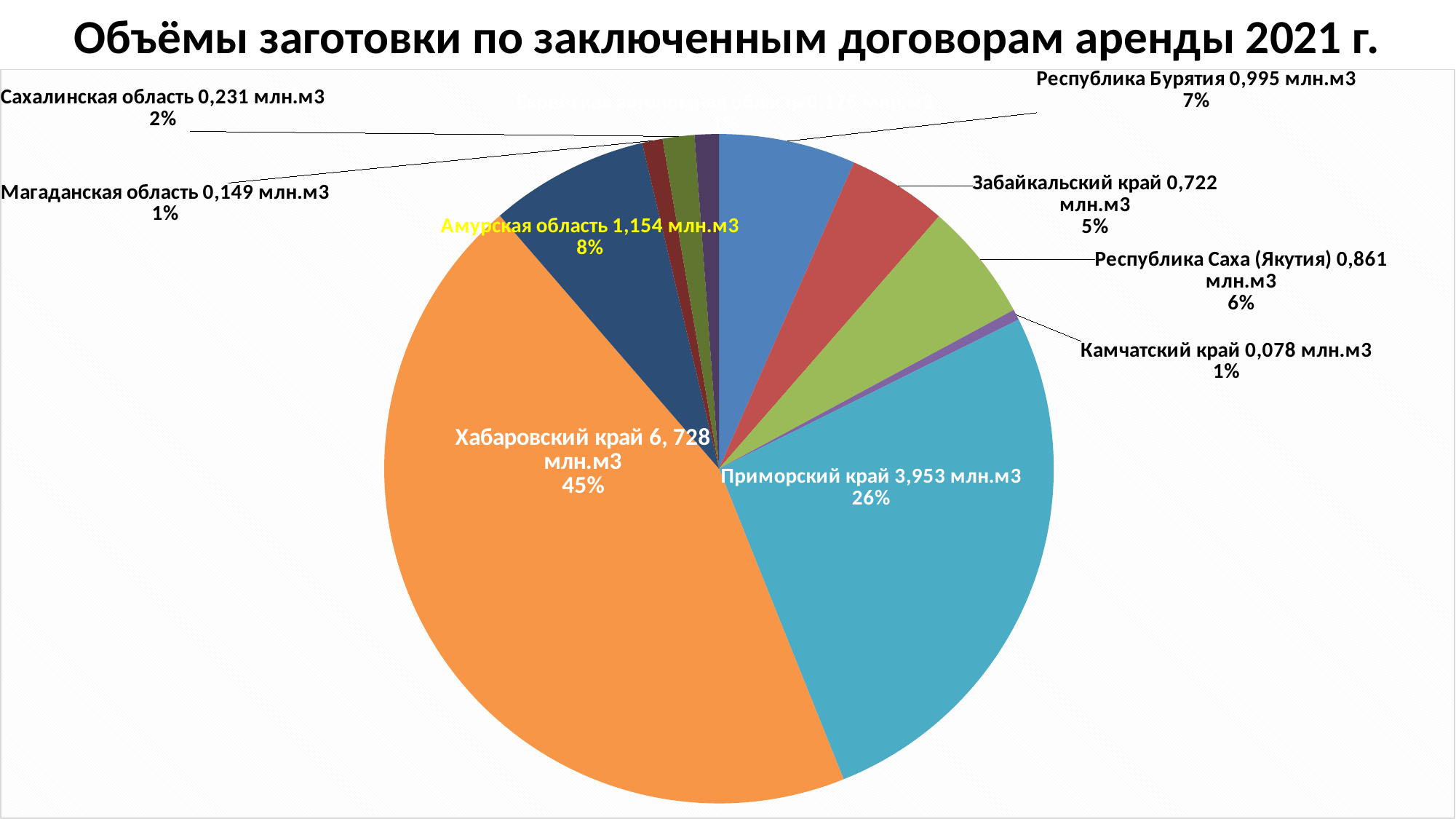
What is the value for Камчатский край? 0,078 млн.м3 What is the value for Приморский край? 3,953 млн.м3 What is the value for Хабаровский край? 6, 728 млн.м3 What share of the pie does Приморский край have? 26% What is the title of the chart? Объёмы заготовки по заключенным договорам аренды 2021 г. What is the difference between the values for Хабаровский край and Приморский край, in млн.м3? 2,775 млн.м3 How many slices does the pie chart have? 10 Which region has the largest slice of the pie? Хабаровский край What is the value for Республика Бурятия? 0,995 млн.м3 Which is larger, the value for Забайкальский край or the value for Республика Саха (Якутия)? Республика Саха (Якутия) What kind of chart is shown on the slide? pie chart What share of the pie does Амурская область have? 8%